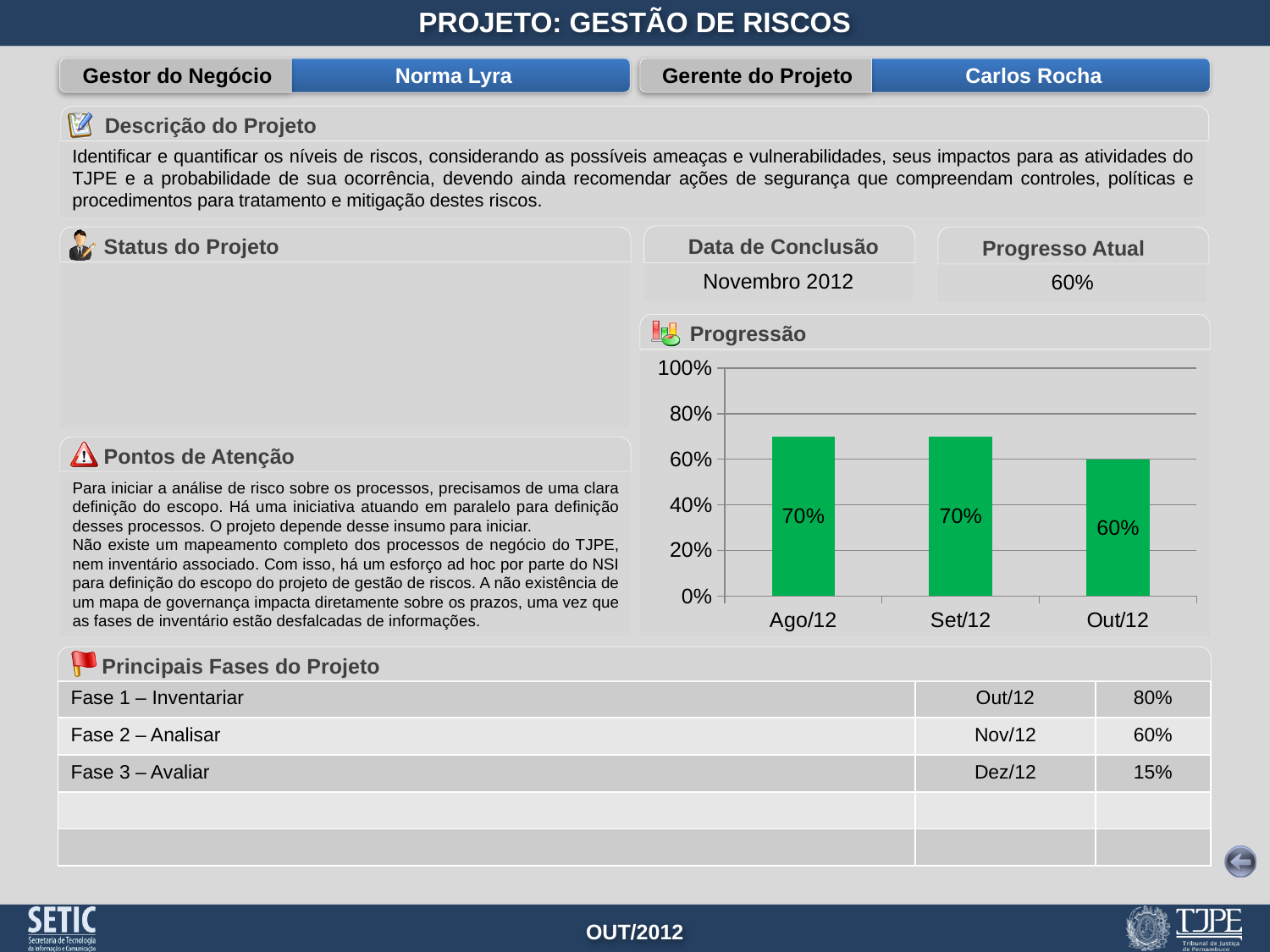
Is the value for Out/12 in the Progressão chart greater or less than 80%? less Is the value for Ago/12 in the Progressão chart greater or less than 60%? greater Do the values in the Progressão chart rise or fall from Set/12 to Out/12? fall What is the value for Ago/12 in the Progressão chart? 70% What is the difference between the values for Set/12 and Out/12 in the Progressão chart? 10% Which month has the lowest value in the Progressão chart? Out/12 How many months are shown on the x axis of the Progressão chart? 3 What is the title of the chart on the slide? Progressão What is the value for Set/12 in the Progressão chart? 70% What is the value for Out/12 in the Progressão chart? 60% Which is larger in the Progressão chart, the value for Ago/12 or the value for Out/12? Ago/12 What kind of chart is the Progressão chart? bar chart